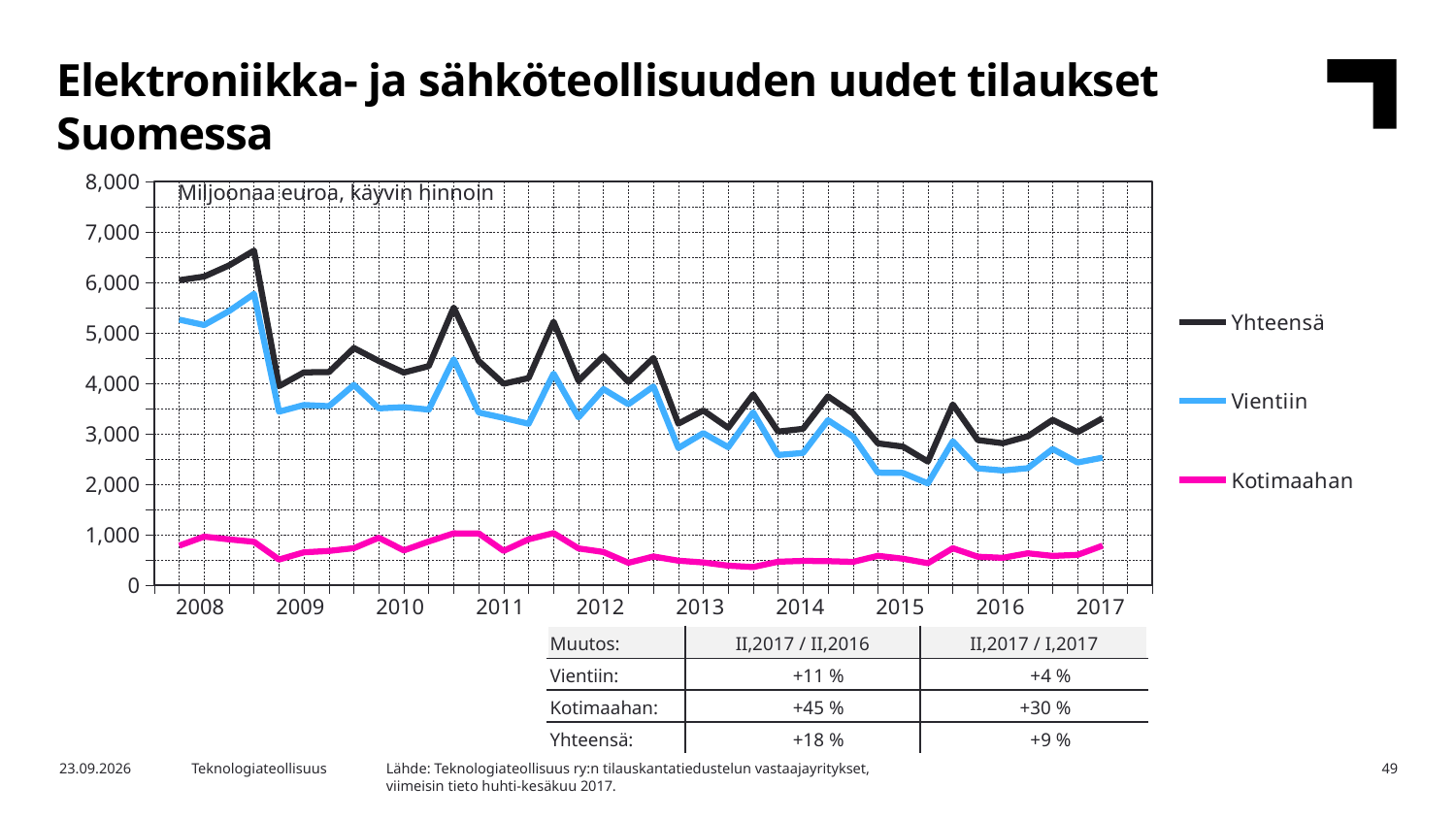
Does the Yhteensä line overall rise or fall from 2008 to 2017? fall Is the value for Vientiin at the end of 2017 greater or less than 3,000? less How many series does the legend list? 3 Which series is plotted with the black line? Yhteensä Which series has the lowest values throughout the chart? Kotimaahan How many years are labelled on the x axis? 10 Is the peak value of Yhteensä in 2008 greater or less than 6,000? greater Which series has the highest values throughout the chart? Yhteensä Is the value for Kotimaahan in 2012 greater or less than 2,000? less What kind of chart is shown on the slide? line chart Which is larger in 2014, Vientiin or Kotimaahan? Vientiin What unit is stated at the top of the chart area? Miljoonaa euroa, käyvin hinnoin